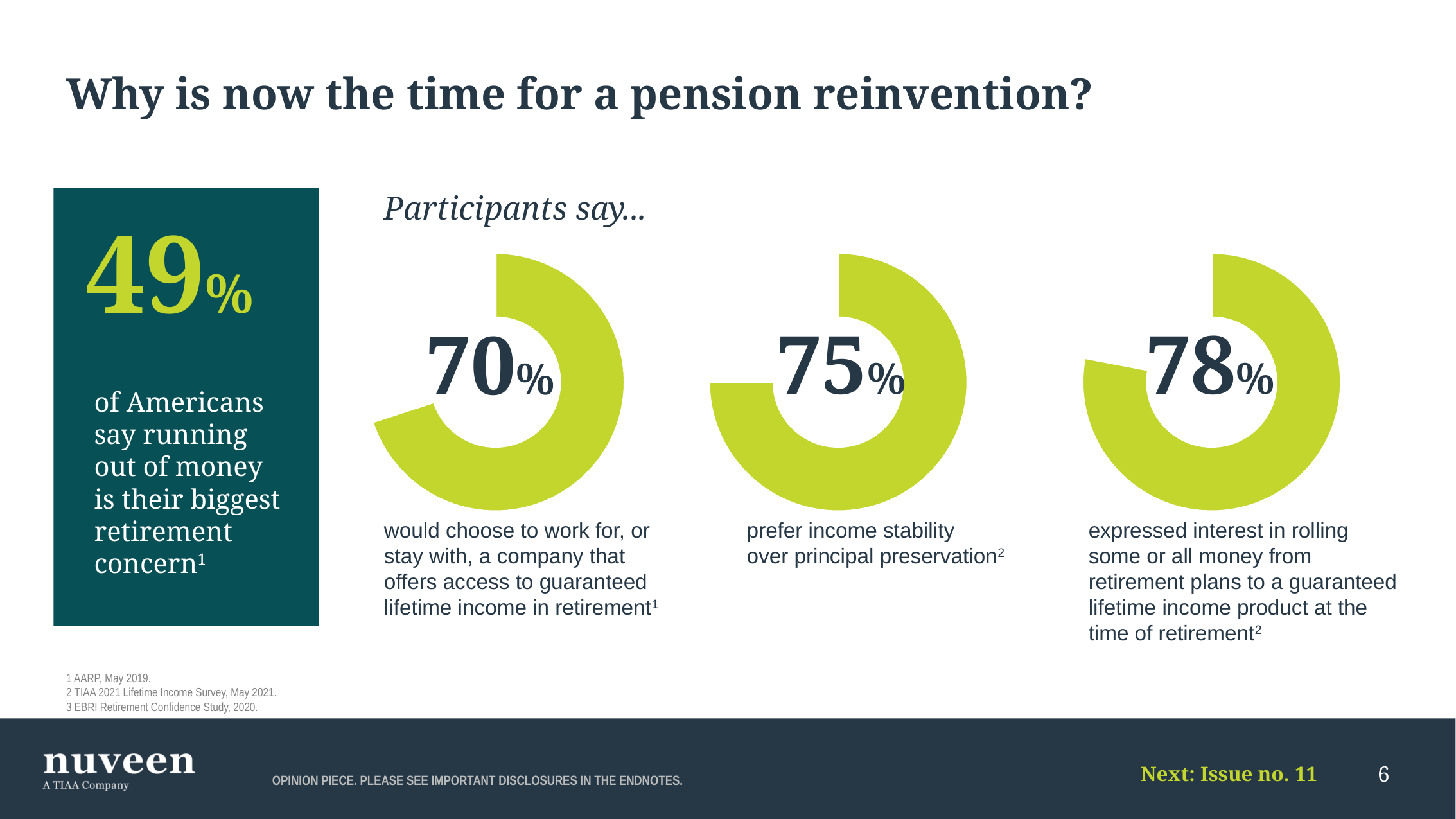
What is the difference between the percentage on the right donut chart and the percentage on the left donut chart? 8 percentage points On the right donut chart, what percentage of participants expressed interest in rolling some or all money from retirement plans to a guaranteed lifetime income product at the time of retirement? 78% How many donut charts are shown on the slide? 3 What heading appears above the three donut charts? Participants say... Do the percentages on the donut charts rise or fall from left to right across the slide? Rise On the middle donut chart, what percentage of participants prefer income stability over principal preservation? 75% What kind of chart is used to show the 70%, 75% and 78% figures? Donut (pie) chart What is the difference between the percentage on the middle donut chart and the percentage on the left donut chart? 5 percentage points Which is larger: the percentage on the middle donut chart or the percentage on the right donut chart? The right donut chart (78%) On the left donut chart, what percentage of participants would choose to work for, or stay with, a company that offers access to guaranteed lifetime income in retirement? 70% Of the three donut charts, which one shows the highest percentage? The right chart (78%), interest in rolling money to a guaranteed lifetime income product Of the three donut charts, which one shows the lowest percentage? The left chart (70%), choosing a company that offers guaranteed lifetime income